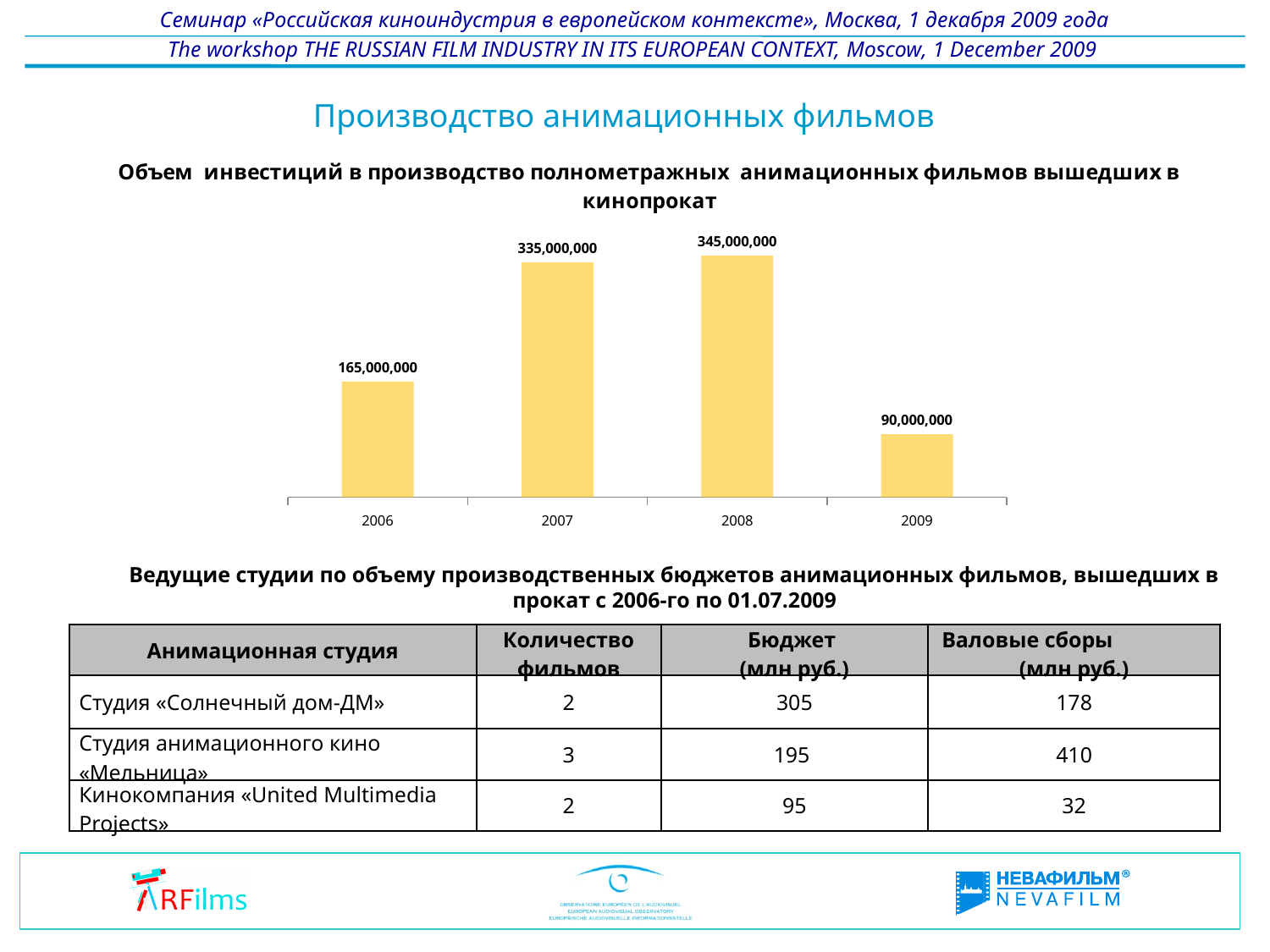
What is the difference between the values for 2008 and 2007? 10,000,000 Which year has the highest value in the chart? 2008 What is the difference between the values for 2007 and 2006? 170,000,000 What kind of chart is shown on the slide? Bar chart Which is larger, the value for 2006 or the value for 2009? 2006 What is the value for 2006 in the chart? 165,000,000 What is the value for 2008 in the chart? 345,000,000 How do the values change from 2006 to 2009 in the chart? They rise from 2006 to 2008, then fall in 2009 How many years are shown on the x axis of the chart? 4 Which year has the lowest value in the chart? 2009 What is the value for 2007 in the chart? 335,000,000 What is the value for 2009 in the chart? 90,000,000